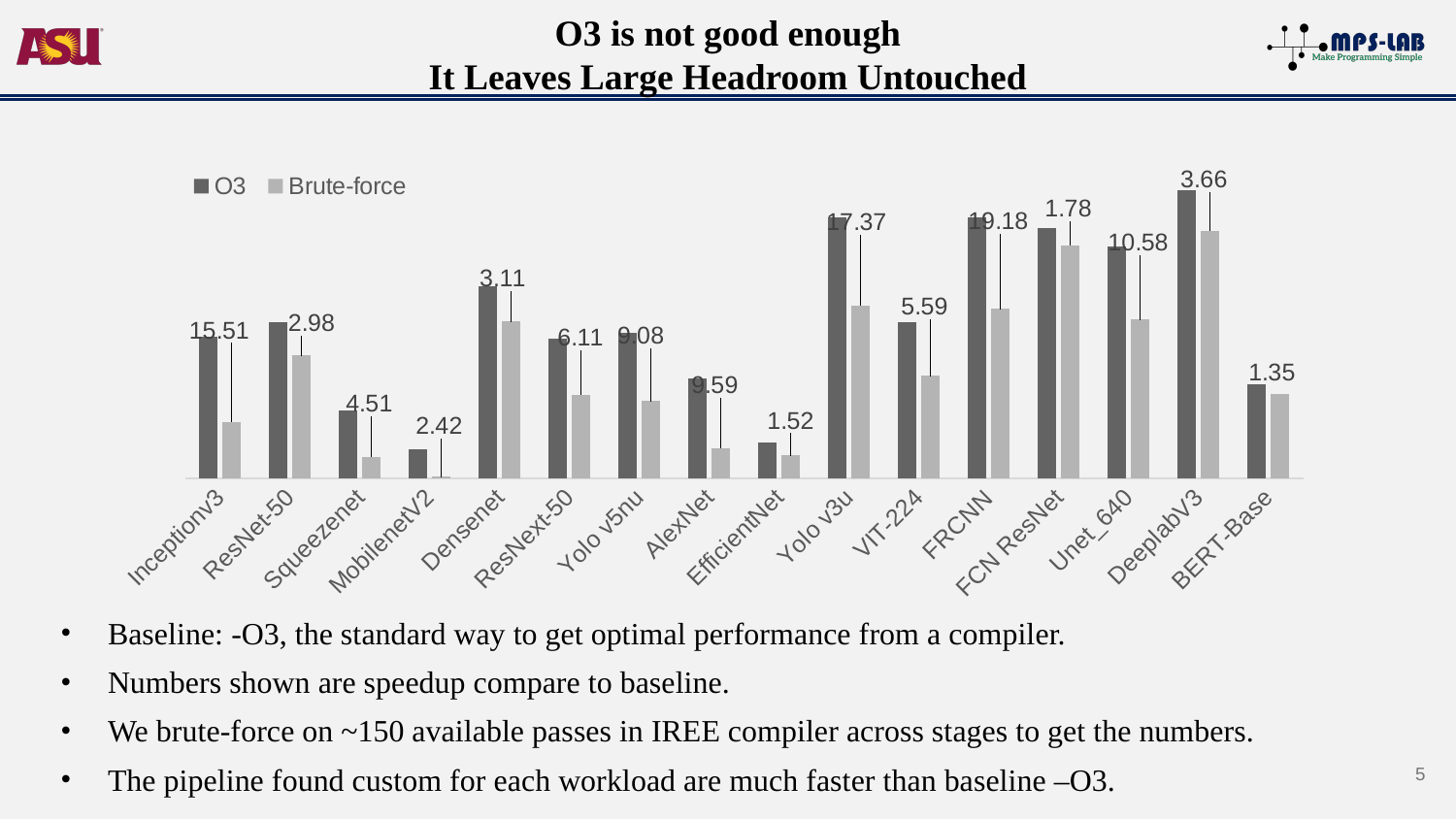
Which category has the tallest O3 bar in the chart? DeeplabV3 What number is shown for FRCNN in the chart? 19.18 What are the two series named in the chart legend? O3 and Brute-force What number is shown for Yolo v3u in the chart? 17.37 What is the difference between the numbers shown for FRCNN and Yolo v3u? 1.81 What kind of chart is shown on the slide? bar chart Which category has the highest number shown in the chart? FRCNN What number is shown for Inceptionv3 in the chart? 15.51 What number is shown for BERT-Base in the chart? 1.35 How many workload categories are shown along the x axis of the chart? 16 How many series does the chart legend list? 2 Which category has the lowest number shown in the chart? BERT-Base